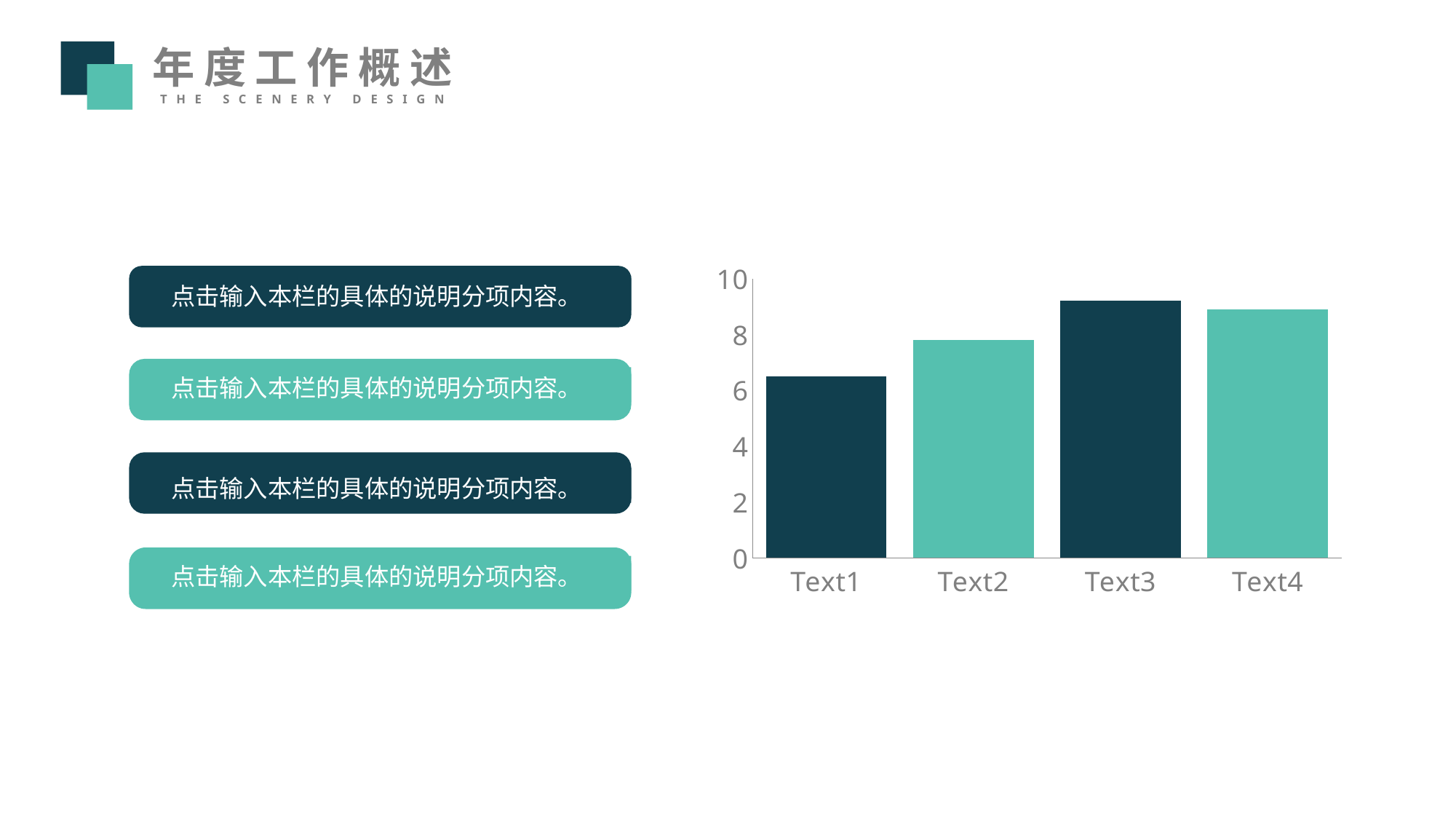
Do the values rise or fall from Text1 to Text3? rise What kind of chart is shown on the slide? bar chart Is the value for Text1 greater or less than 8? less How many categories are shown on the x axis of the chart? 4 Which category has the lowest bar in the chart? Text1 Is the value for Text3 greater or less than 8? greater What is the highest value shown on the y axis of the chart? 10 Which is larger, the value for Text1 or the value for Text2? Text2 Is the value for Text1 greater or less than 6? greater Which is larger, the value for Text2 or the value for Text4? Text4